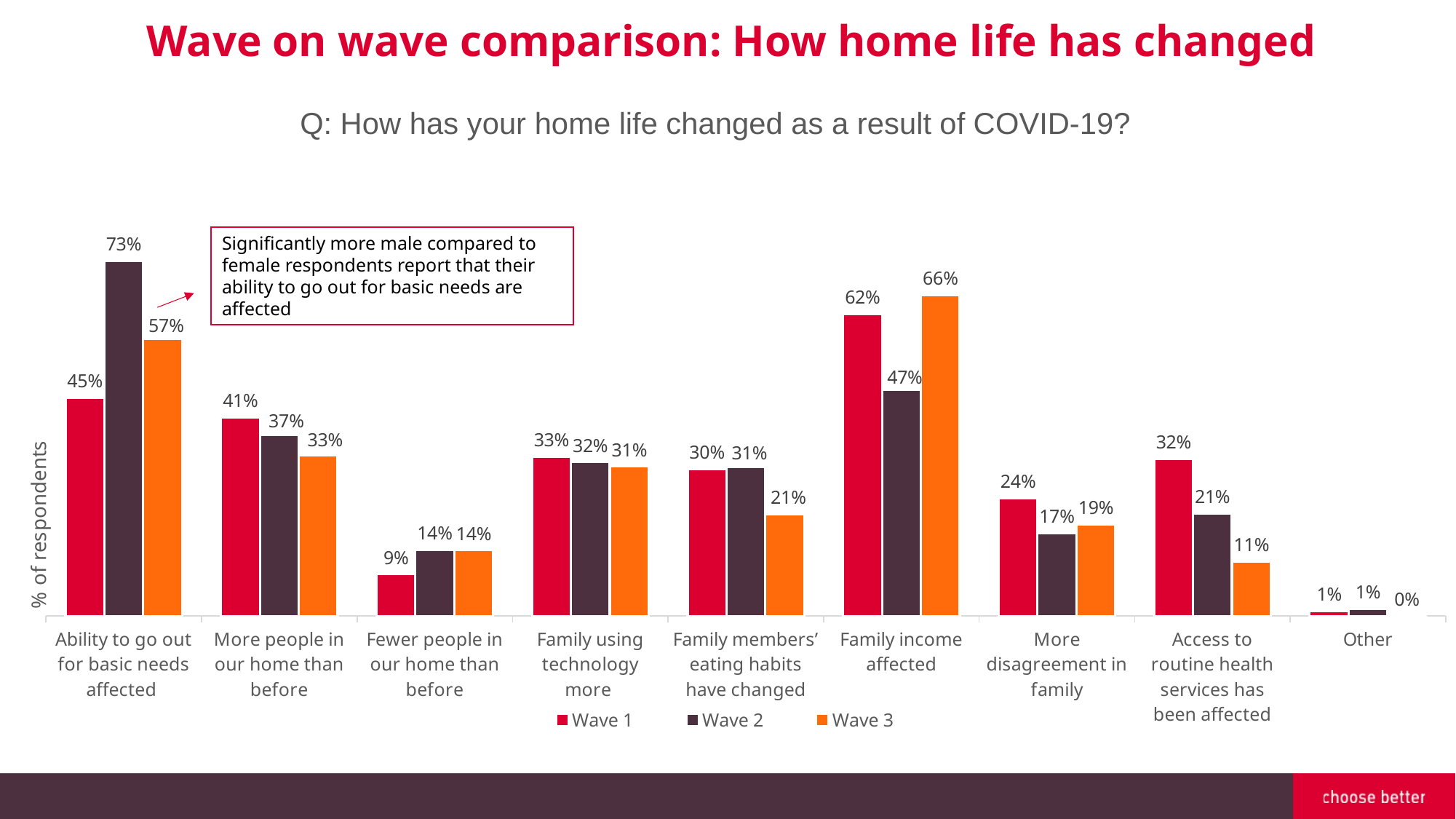
What kind of chart is shown on the slide? Bar chart What is the difference between the Wave 1 and Wave 3 values for 'Access to routine health services has been affected'? 21% What is the Wave 1 value for 'Access to routine health services has been affected'? 32% What is the difference between the Wave 2 and Wave 1 values for 'Ability to go out for basic needs affected'? 28% For 'Family income affected', which is larger: the Wave 2 value or the Wave 3 value? Wave 3 How many categories are shown on the x axis? 9 How many series does the legend list? 3 Which category has the highest Wave 1 value? Family income affected Do the values for 'Access to routine health services has been affected' rise or fall from Wave 1 to Wave 3? Fall What is the Wave 3 value for 'Family income affected'? 66% Which category has the lowest Wave 3 value? Other What is the Wave 2 value for 'Ability to go out for basic needs affected'? 73%